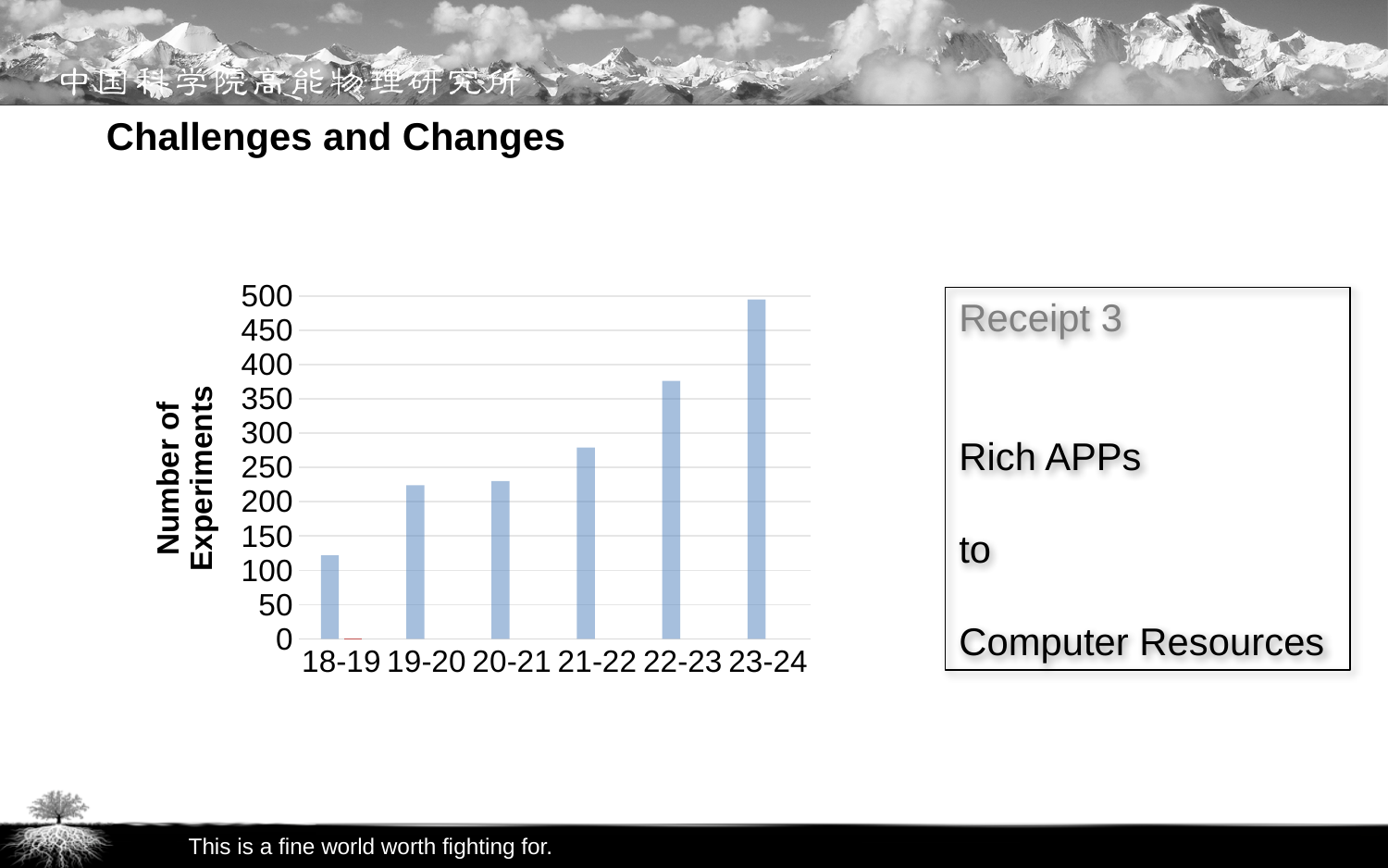
Is the value for 21-22 greater or less than 300? less Is the value for 19-20 greater or less than 200? greater Is the value for 22-23 greater or less than 350? greater Which category has the lowest number of experiments? 18-19 Do the values rise or fall along the x axis from 18-19 to 23-24? rise What kind of chart is shown on the slide? bar chart What is the title of the y axis of the chart? Number of Experiments Which category has the highest number of experiments? 23-24 How many categories are shown on the x axis of the chart? 6 Which is larger, the value for 21-22 or the value for 22-23? 22-23